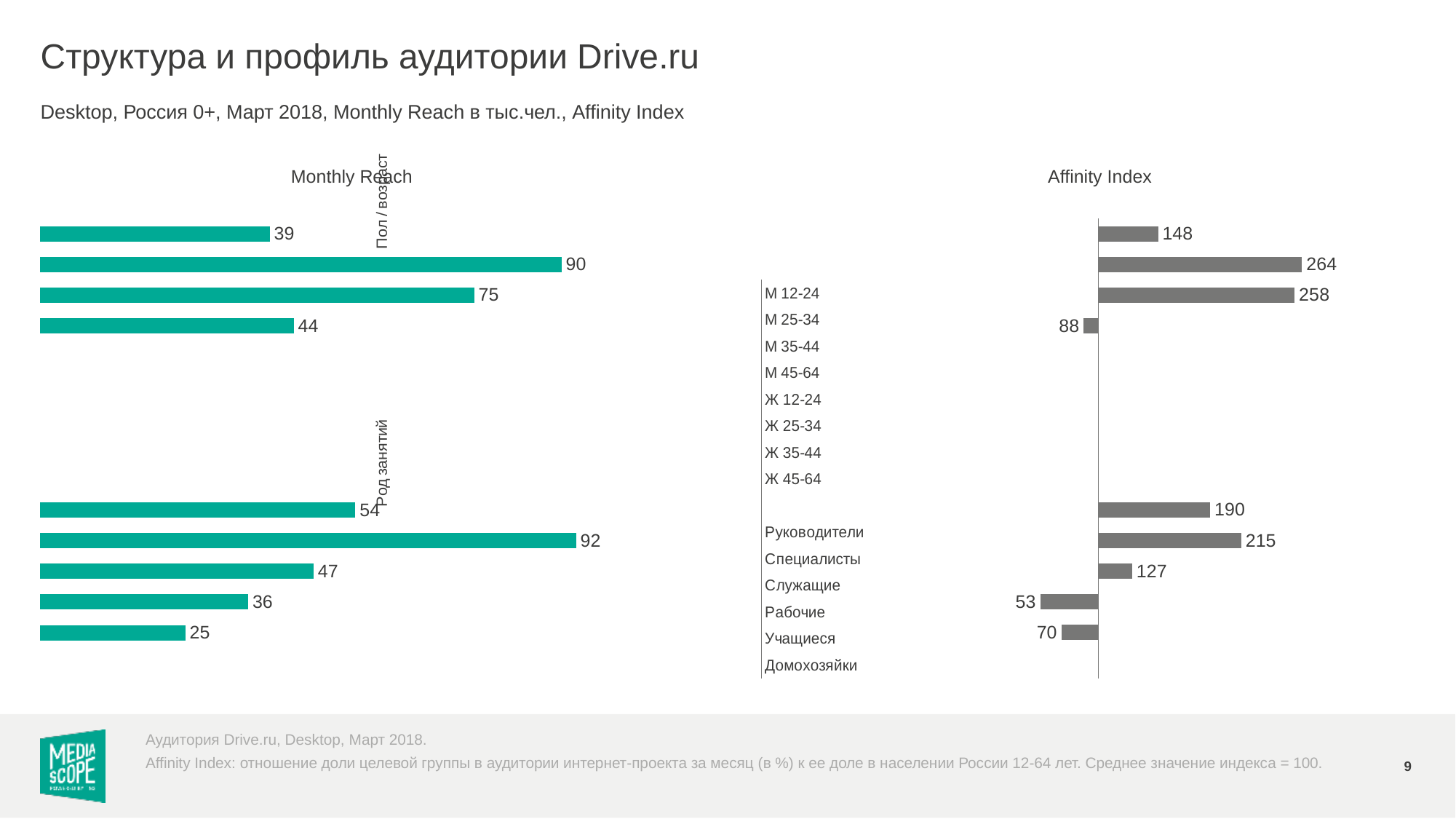
In the Affinity Index chart, how many bars extend to the left of the vertical axis line? 3 In the Monthly Reach chart, what is the difference between the highest value (92) and the lowest value (25)? 67 How many bars are plotted in the Monthly Reach chart? 9 How many bars are plotted in the Affinity Index chart? 9 In the Affinity Index chart, what is the highest value shown? 264 In the Monthly Reach chart, what is the lowest value shown? 25 In the Monthly Reach chart, what is the value of the topmost bar? 39 What kind of chart is the Monthly Reach chart on the left? Bar chart In the Monthly Reach chart, what is the highest value shown? 92 What colour are the bars in the Monthly Reach chart? Teal (green) In the Affinity Index chart, what is the difference between the highest value (264) and the lowest value (53)? 211 In the Affinity Index chart, what is the lowest value shown? 53